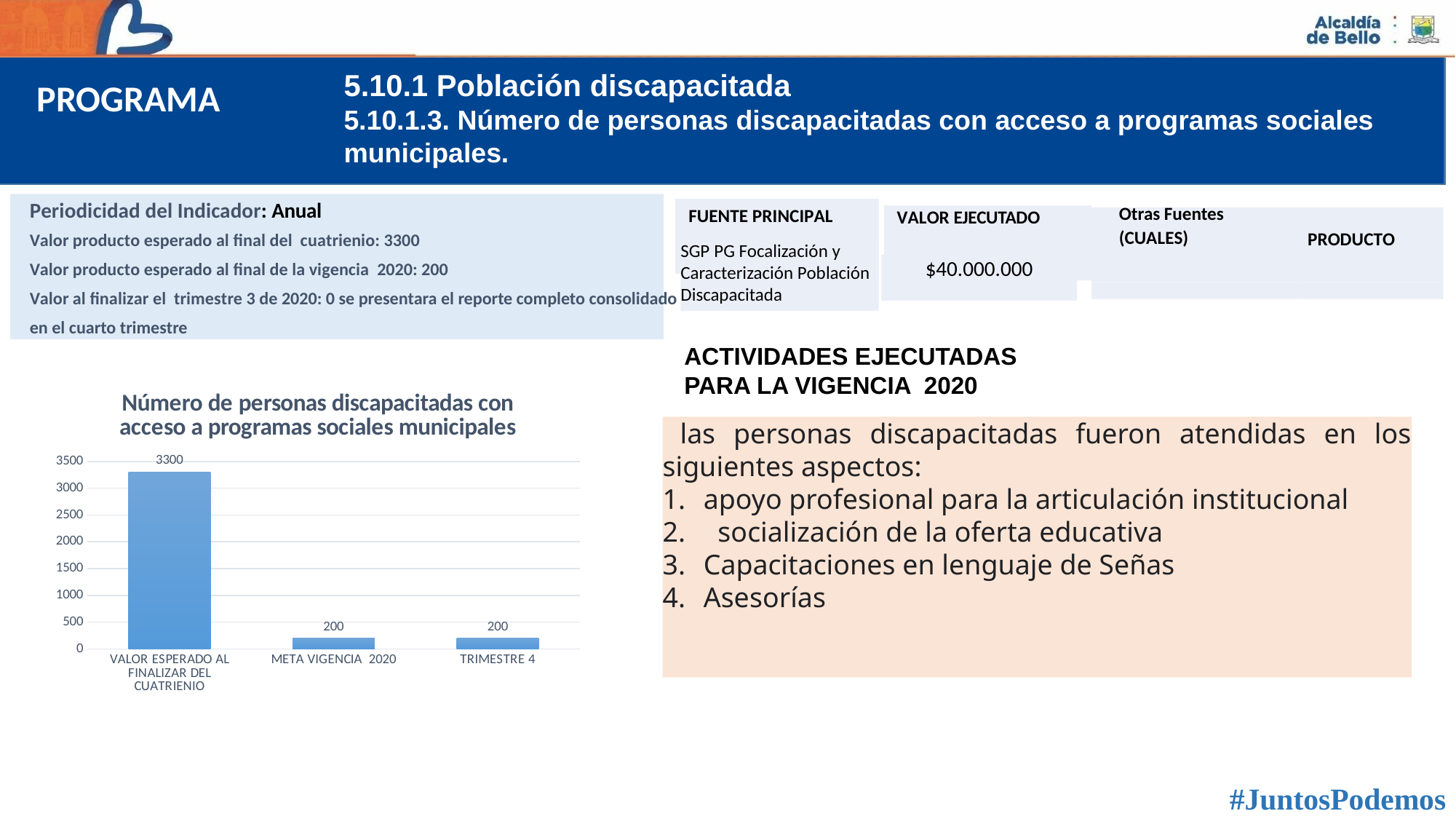
What is the highest value shown on the vertical axis of the chart? 3500 Is the value for VALOR ESPERADO AL FINALIZAR DEL CUATRIENIO greater or less than 3000? greater What is the difference between the value for VALOR ESPERADO AL FINALIZAR DEL CUATRIENIO and the value for META VIGENCIA 2020? 3100 What is the title of the chart? Número de personas discapacitadas con acceso a programas sociales municipales What is the value for TRIMESTRE 4? 200 Is the value for META VIGENCIA 2020 greater or less than 500? less How many categories are shown on the chart? 3 What is the value for META VIGENCIA 2020? 200 What is the value for VALOR ESPERADO AL FINALIZAR DEL CUATRIENIO? 3300 Which is larger, the value for VALOR ESPERADO AL FINALIZAR DEL CUATRIENIO or the value for TRIMESTRE 4? VALOR ESPERADO AL FINALIZAR DEL CUATRIENIO Which category has the highest value? VALOR ESPERADO AL FINALIZAR DEL CUATRIENIO What kind of chart is shown on the slide? bar chart